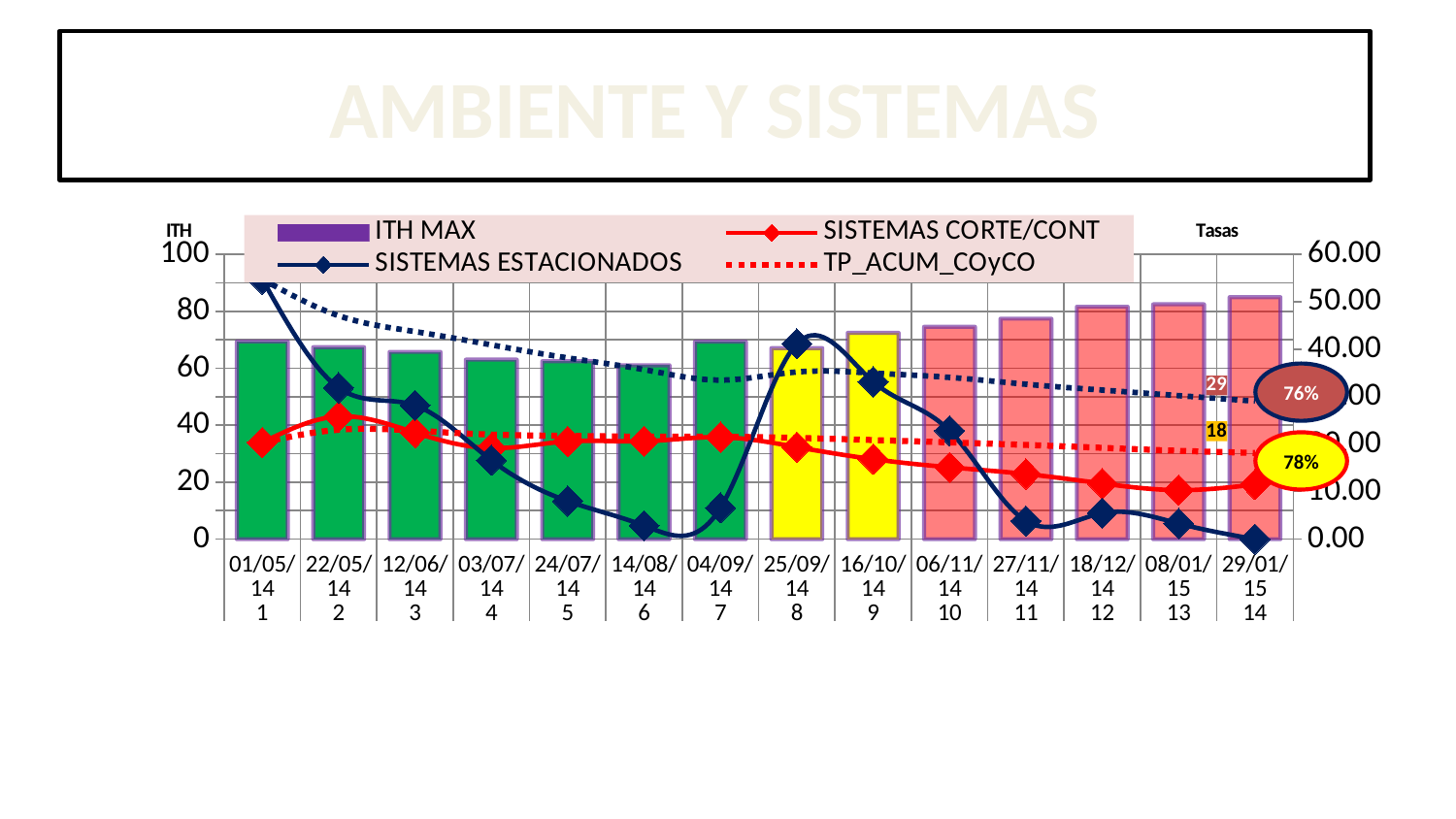
How many dates (categories) are shown along the x axis? 14 Does the SISTEMAS ESTACIONADOS line generally rise or fall from 01/05/14 to 29/01/15? fall Is the ITH MAX bar for 14/08/14 greater or less than 80? less Which series is drawn as bars? ITH MAX How many series does the legend list? 4 What kind of chart is shown on the slide? A combined bar and line chart What is the label of the right-hand vertical axis? Tasas At 01/05/14, which is larger: SISTEMAS ESTACIONADOS or SISTEMAS CORTE/CONT? SISTEMAS ESTACIONADOS At which date is the SISTEMAS ESTACIONADOS line at its highest? 01/05/14 At which date is the SISTEMAS ESTACIONADOS line at its lowest? 29/01/15 Is the ITH MAX bar for 01/05/14 greater or less than 60? greater Is the ITH MAX bar for 29/01/15 greater or less than 80? greater